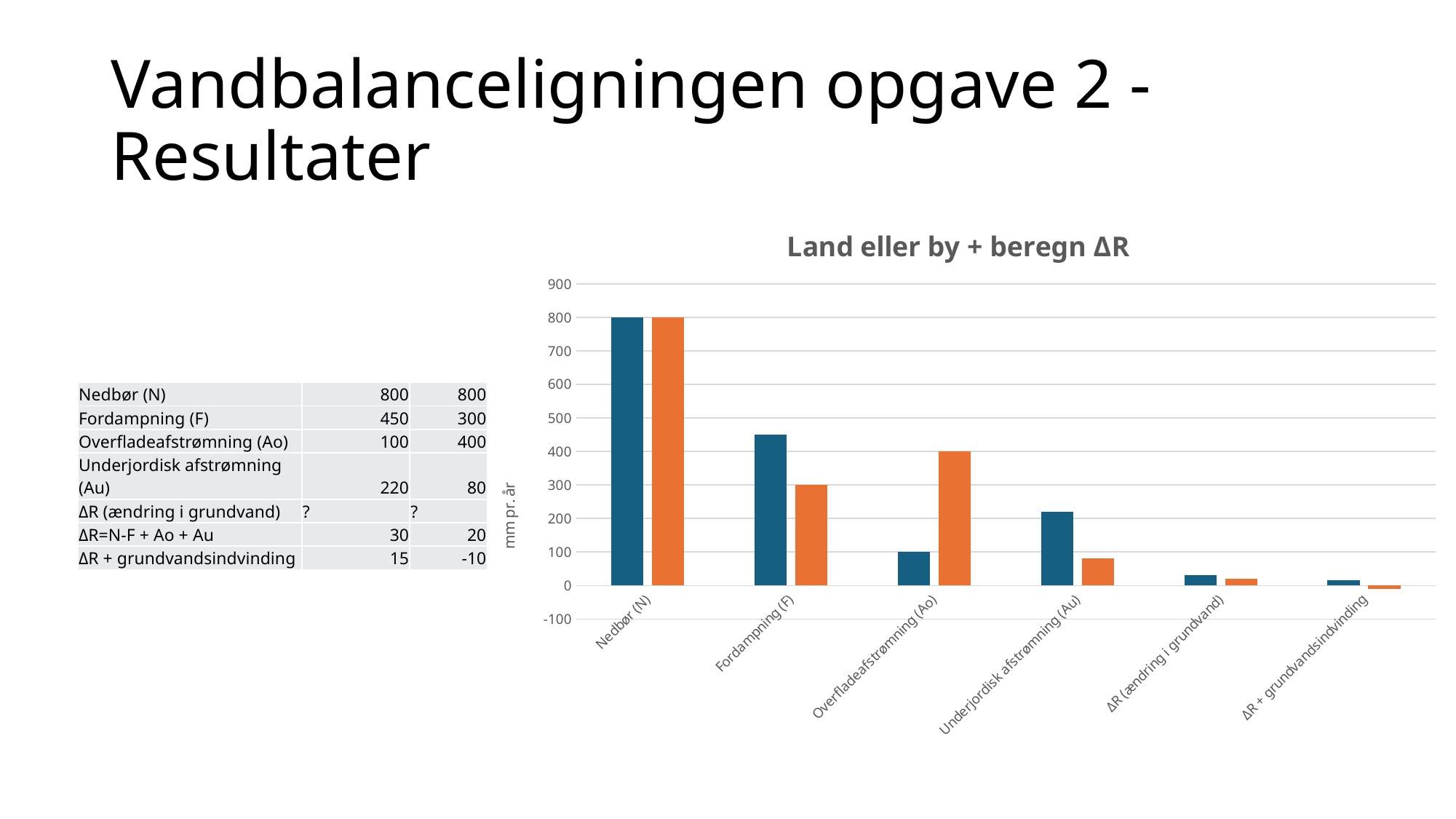
Is the value of the orange bar for ΔR + grundvandsindvinding greater or less than 0? less For Fordampning (F), which bar is taller, the blue one or the orange one? blue For Overfladeafstrømning (Ao), which bar is taller, the blue one or the orange one? orange Is the value of the orange bar for Fordampning (F) greater or less than 400? less How many categories are shown on the x axis of the chart? 6 What kind of chart is shown on the slide? bar chart Which category has the highest bars in the chart? Nedbør (N) Do the bar heights generally rise or fall moving from left to right along the x axis? fall What is the value of the blue bar for Nedbør (N)? 800 What is the title of the chart? Land eller by + beregn ΔR What is the label on the vertical axis of the chart? mm pr. år Is the value of the blue bar for Underjordisk afstrømning (Au) greater or less than 100? greater